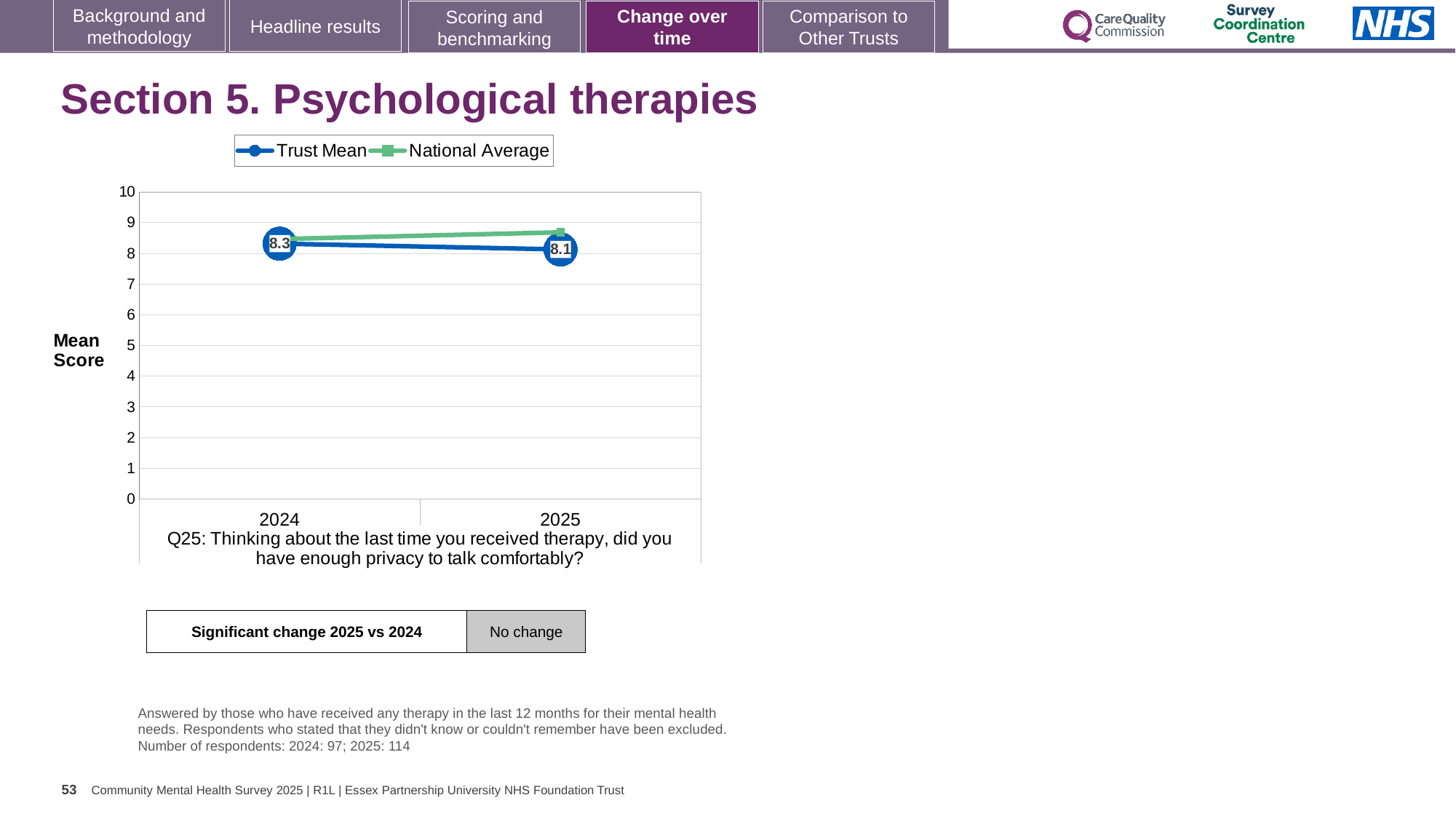
By how much did the Trust Mean change from 2024 to 2025? 0.2 Is the National Average value for 2025 greater or less than 8? greater How many years are plotted on the x axis? 2 In which year is the Trust Mean higher? 2024 Does the Trust Mean rise or fall from 2024 to 2025? fall What is the Trust Mean value for 2025? 8.1 In 2025, which is larger: the Trust Mean or the National Average? National Average What is the label on the y axis of the chart? Mean Score What is the Trust Mean value for 2024? 8.3 Is the National Average value for 2024 greater or less than 9? less How many series does the legend list? 2 What kind of chart is shown on the slide? line chart